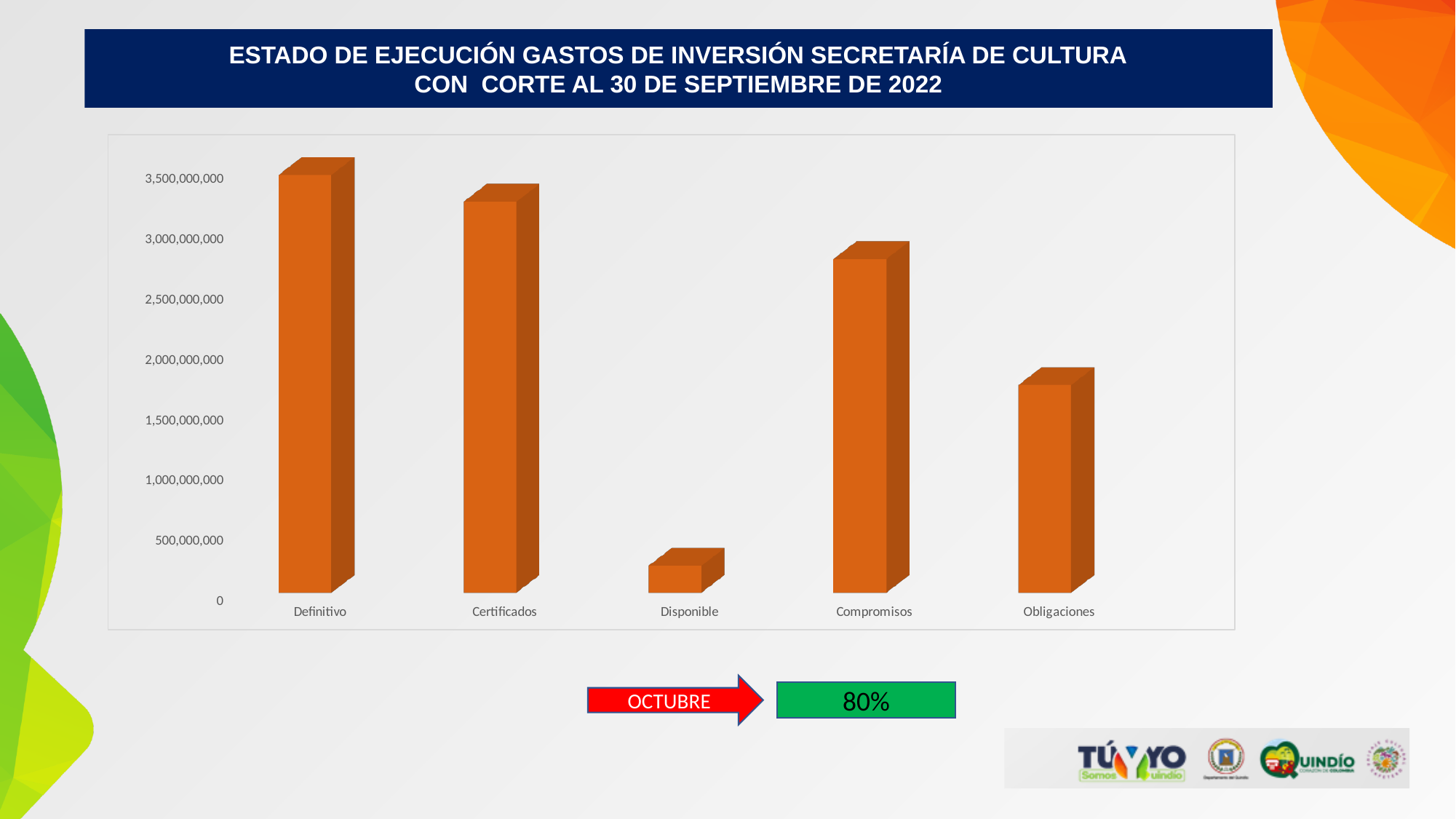
How many categories are plotted on the chart? 5 Which category has the highest value? Definitivo Which is larger, the value for Certificados or the value for Compromisos? Certificados Is the value for Compromisos greater or less than 3,000,000,000? less What colour are the bars in the chart? orange Is the value for Obligaciones greater or less than 2,000,000,000? less Is the value for Definitivo greater or less than 3,000,000,000? greater What kind of chart is shown on the slide? bar chart Which category has the lowest value? Disponible Which is larger, the value for Obligaciones or the value for Disponible? Obligaciones